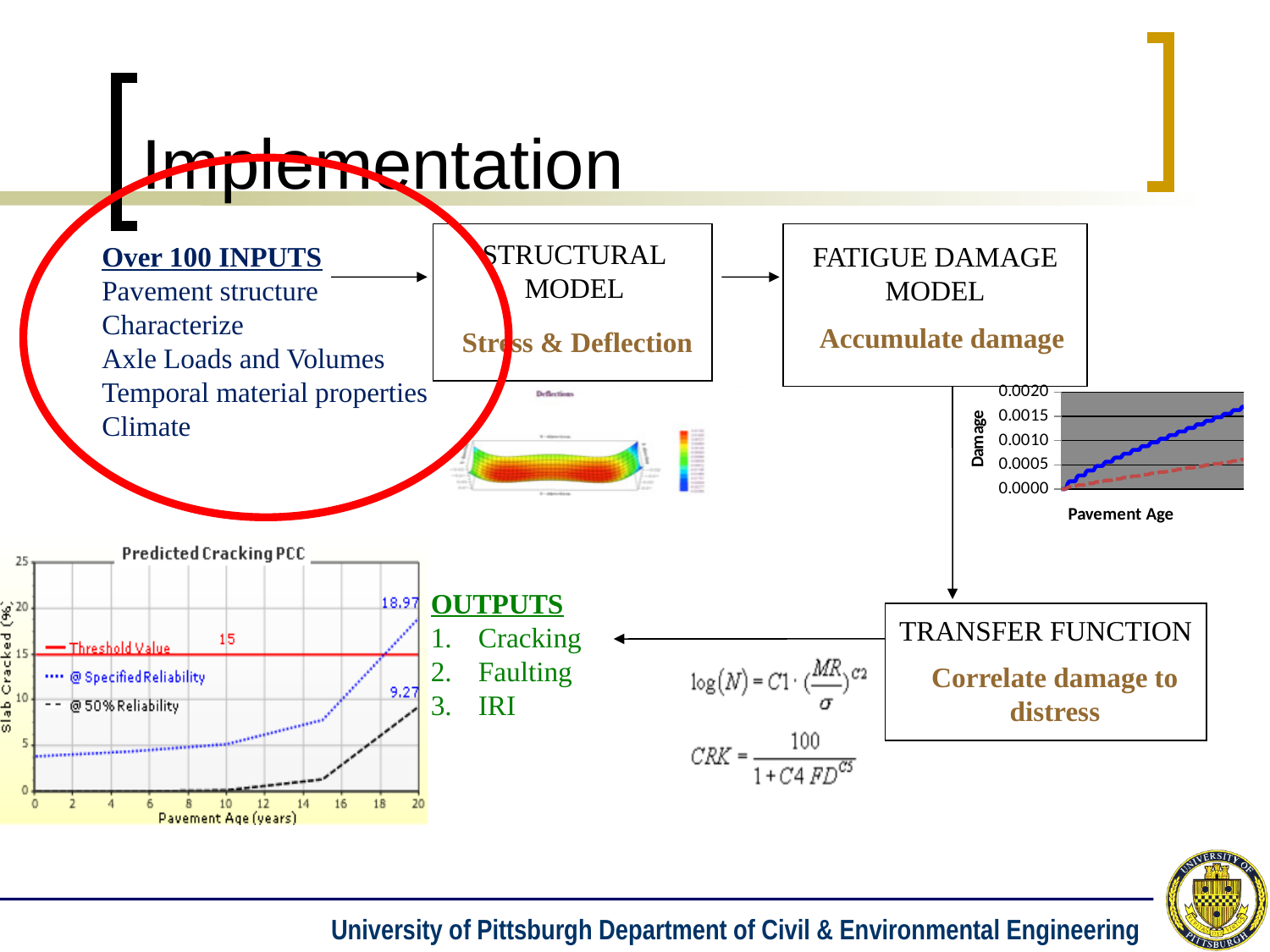
In the 'Predicted Cracking PCC' chart, what kind of chart is it? line chart In the Damage vs Pavement Age chart on the right, is the final value of the solid blue line greater or less than 0.0010? greater In the 'Predicted Cracking PCC' chart, at 20 years, which is larger: '@ Specified Reliability' or '@ 50% Reliability'? @ Specified Reliability In the 'Predicted Cracking PCC' chart, is the '@ 50% Reliability' value at 20 years greater or less than 10? less In the 'Predicted Cracking PCC' chart, what is the x-axis label? Pavement Age (years) In the 'Predicted Cracking PCC' chart, what is the difference between the '@ Specified Reliability' and '@ 50% Reliability' values at 20 years? 9.70 In the 'Predicted Cracking PCC' chart, does the '@ Specified Reliability' line rise or fall as Pavement Age increases? rise In the 'Predicted Cracking PCC' chart, how many series does the legend list? 3 In the 'Predicted Cracking PCC' chart, what is the value of '@ Specified Reliability' at 20 years? 18.97 In the Damage vs Pavement Age chart on the right, does the solid blue line rise or fall as Pavement Age increases? rise In the 'Predicted Cracking PCC' chart, what is the Threshold Value? 15 In the 'Predicted Cracking PCC' chart, what is the value of '@ 50% Reliability' at 20 years? 9.27